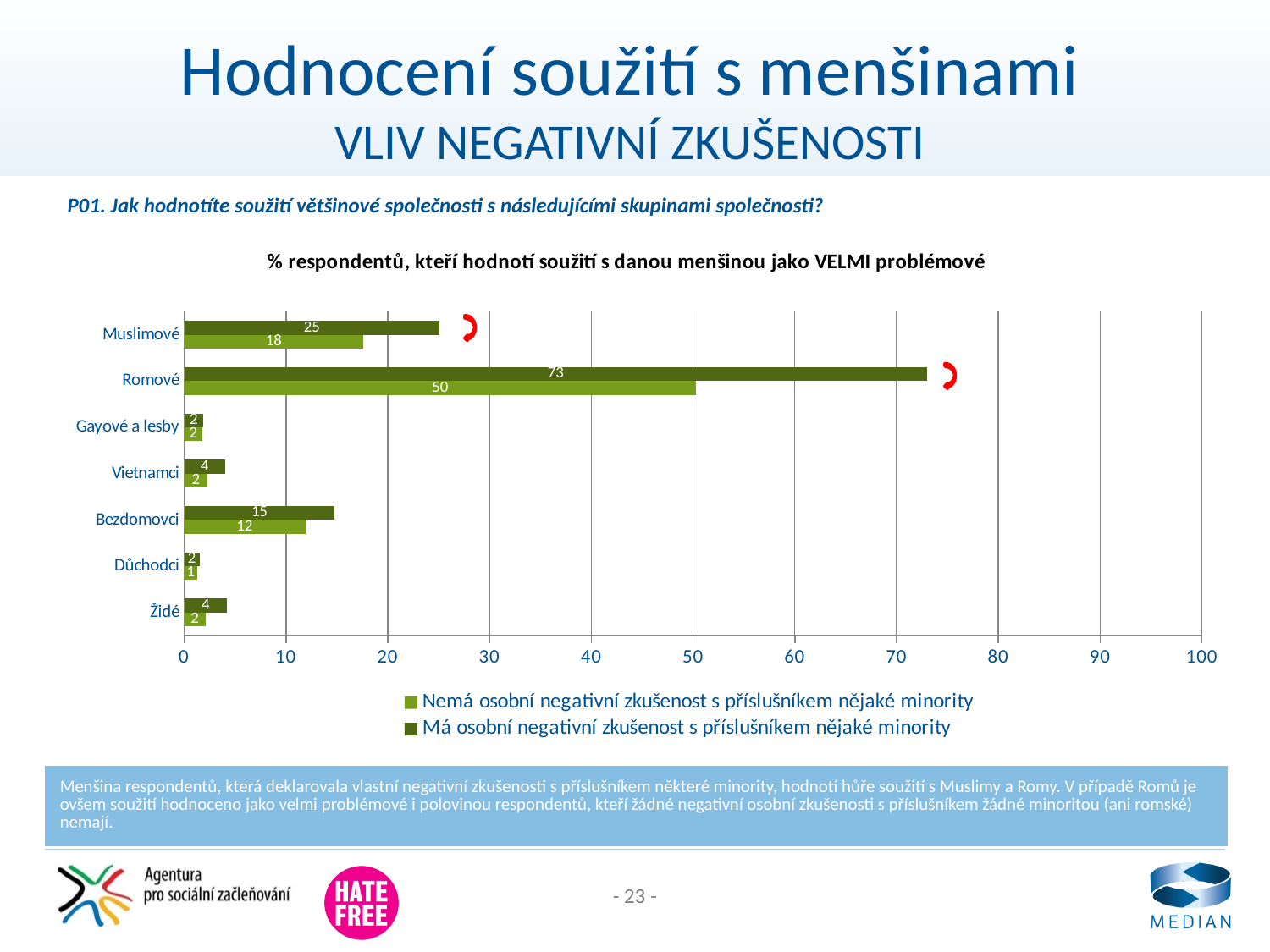
Is the value for Romové in the series 'Má osobní negativní zkušenost s příslušníkem nějaké minority' greater or less than 70? greater What is the title of the chart? % respondentů, kteří hodnotí soužití s danou menšinou jako VELMI problémové Which category has the highest value in the series 'Nemá osobní negativní zkušenost s příslušníkem nějaké minority'? Romové How many minority groups (categories) are shown on the chart? 7 Which category has the lowest value in the series 'Nemá osobní negativní zkušenost s příslušníkem nějaké minority'? Důchodci What is the difference between the two series values for Romové? 23 What is the value for Bezdomovci in the series 'Má osobní negativní zkušenost s příslušníkem nějaké minority'? 15 Which is larger for Muslimové: the value for respondents with a negative experience ('Má') or without ('Nemá')? Má osobní negativní zkušenost s příslušníkem nějaké minority What is the value for Romové in the series 'Má osobní negativní zkušenost s příslušníkem nějaké minority'? 73 What type of chart is shown on the slide? bar chart What is the value for Muslimové in the series 'Nemá osobní negativní zkušenost s příslušníkem nějaké minority'? 18 How many series does the legend list? 2